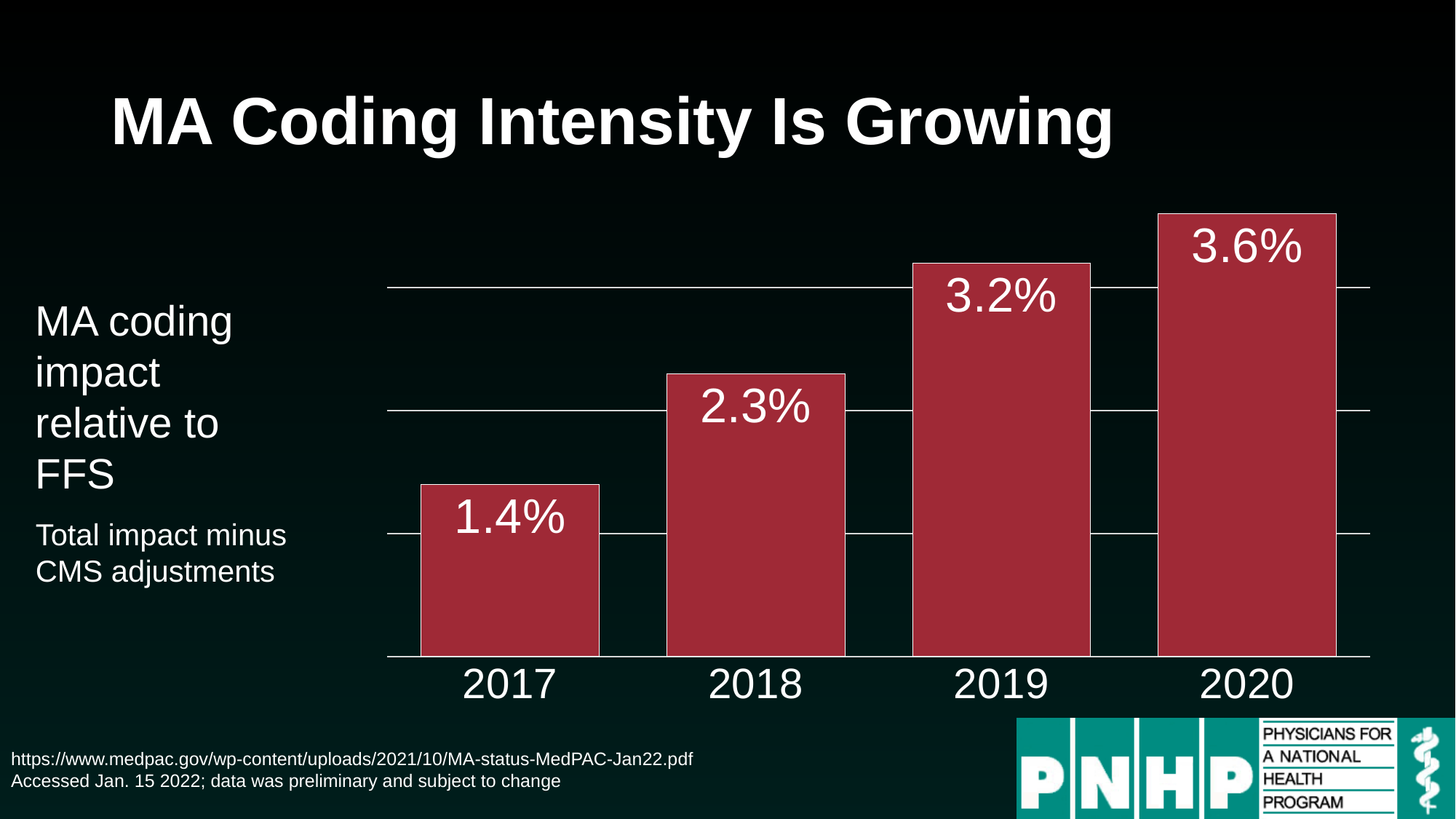
What is the MA coding impact relative to FFS for 2017? 1.4% What kind of chart is shown on the slide? Bar chart What is the difference between the 2020 and 2017 values? 2.2% Which is larger, the value for 2018 or the value for 2019? 2019 What is the MA coding impact relative to FFS for 2018? 2.3% What is the difference between the 2019 and 2018 values? 0.9% What is the MA coding impact relative to FFS for 2020? 3.6% Which year has the lowest MA coding impact? 2017 What is the MA coding impact relative to FFS for 2019? 3.2% Which year has the highest MA coding impact? 2020 How many years are shown on the chart? 4 Do the values rise or fall from 2017 to 2020? Rise